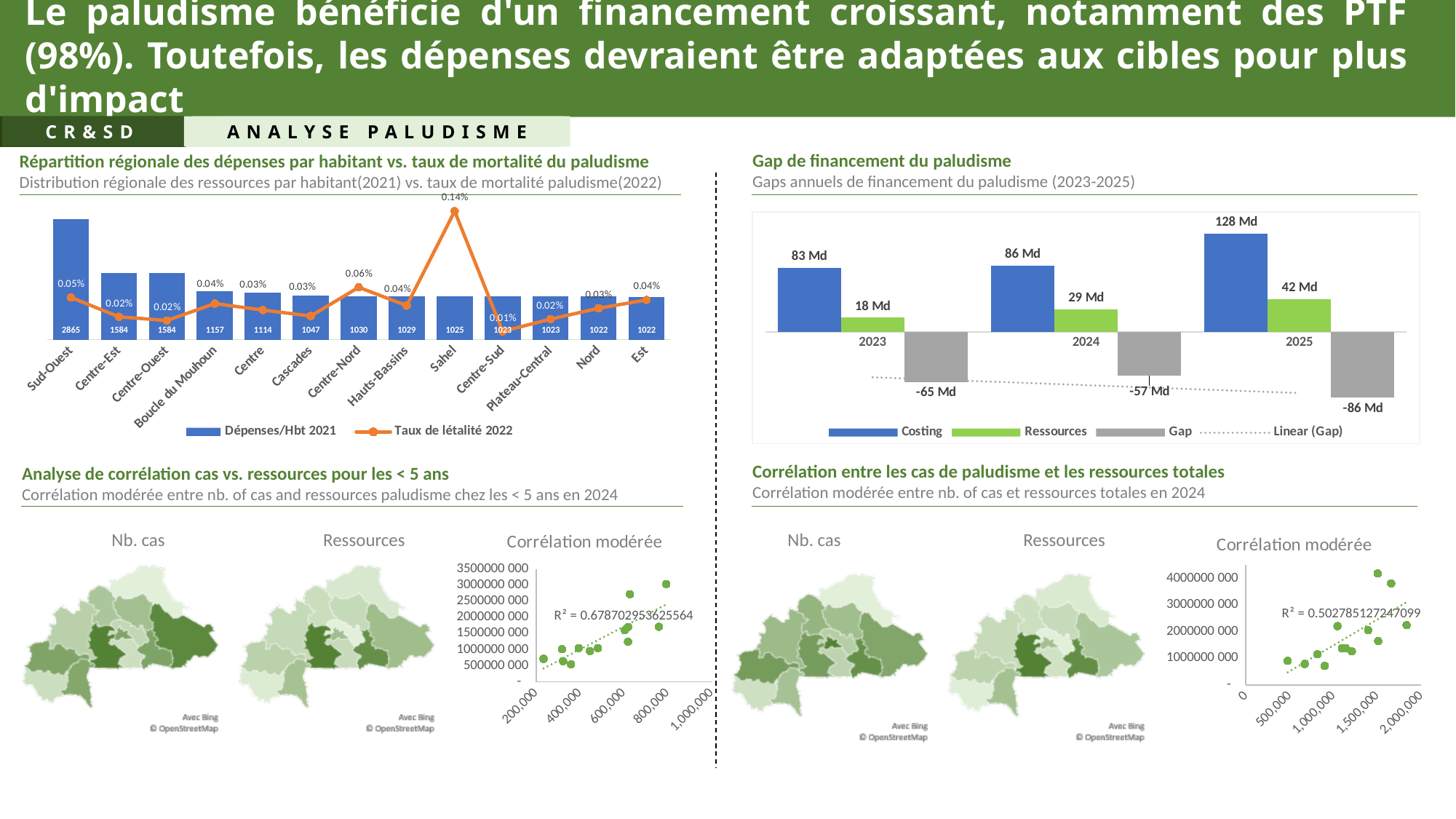
In the 'Répartition régionale des dépenses par habitant vs. taux de mortalité du paludisme' chart, what is the Taux de létalité 2022 for Sahel? 0.14% In the 'Gap de financement du paludisme' chart, is the Costing value larger in 2024 or in 2025? 2025 In the 'Répartition régionale des dépenses par habitant vs. taux de mortalité du paludisme' chart, what is the Dépenses/Hbt 2021 value for Sud-Ouest? 2865 In the 'Répartition régionale des dépenses par habitant vs. taux de mortalité du paludisme' chart, how many regions are shown on the x axis? 13 In the 'Répartition régionale des dépenses par habitant vs. taux de mortalité du paludisme' chart, which region has the highest Dépenses/Hbt 2021? Sud-Ouest In the 'Corrélation entre les cas de paludisme et les ressources totales' scatter chart, what R² value is shown? R² = 0.502785127247099 In the 'Gap de financement du paludisme' chart, what is the Gap value for 2024? -57 Md In the 'Répartition régionale des dépenses par habitant vs. taux de mortalité du paludisme' chart, which region has the lowest Taux de létalité 2022? Centre-Sud In the 'Gap de financement du paludisme' chart, how many entries does the legend list? 4 In the 'Gap de financement du paludisme' chart, what is the Ressources value for 2023? 18 Md In the 'Gap de financement du paludisme' chart, what is the Costing value for 2025? 128 Md In the 'Répartition régionale des dépenses par habitant vs. taux de mortalité du paludisme' chart, what is the difference in Dépenses/Hbt 2021 between Sud-Ouest and Centre-Est? 1281